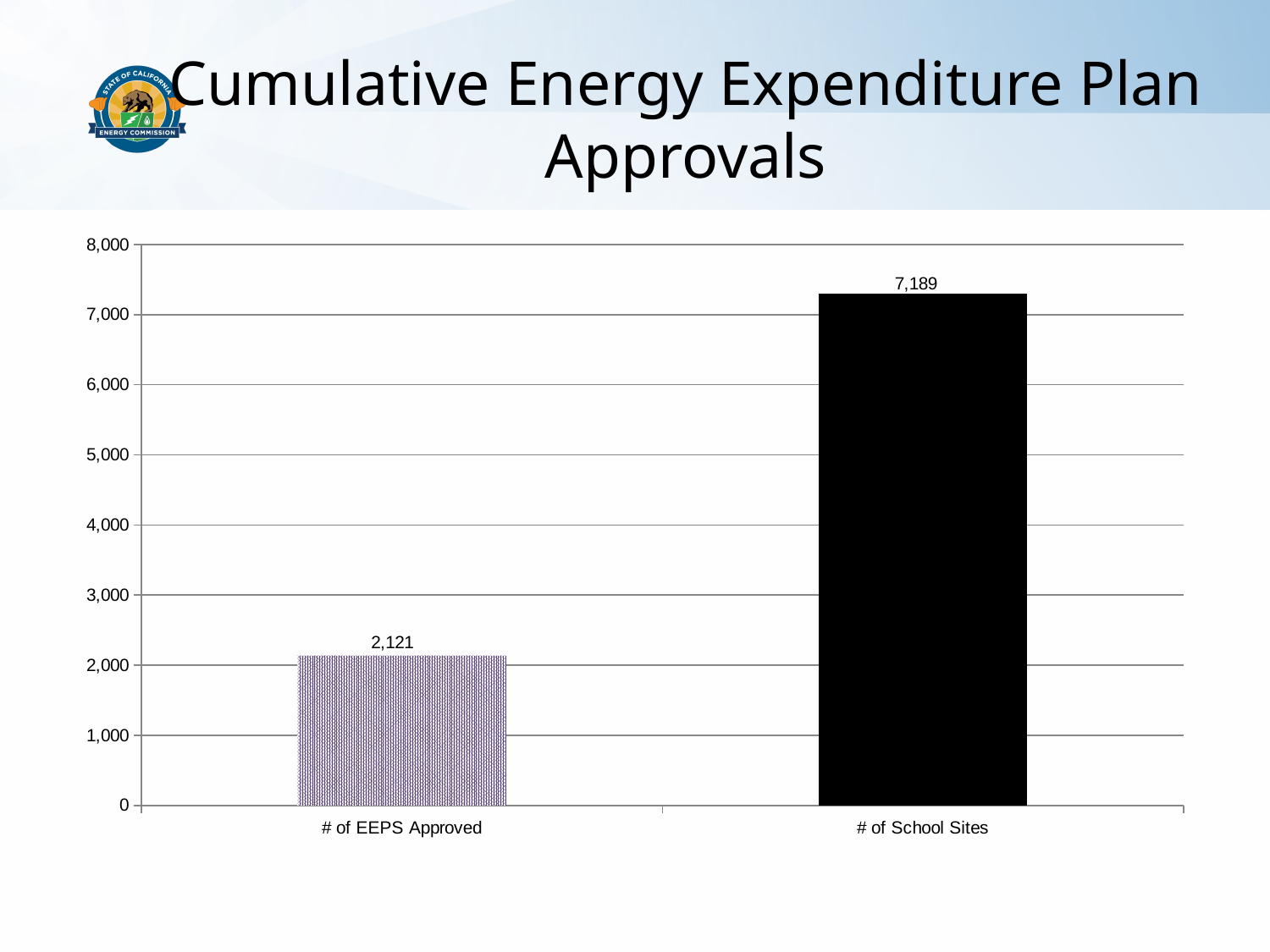
What is the difference between # of School Sites and # of EEPS Approved? 5,068 What is the title of the slide? Cumulative Energy Expenditure Plan Approvals How many categories are shown in the chart? 2 Is the value for # of School Sites greater or less than 7,000? greater What kind of chart is shown on the slide? bar chart Which is larger, # of EEPS Approved or # of School Sites? # of School Sites What is the value for # of EEPS Approved? 2,121 What is the value for # of School Sites? 7,189 Which category has the lowest value? # of EEPS Approved Is the value for # of EEPS Approved greater or less than 3,000? less Which category has the highest value? # of School Sites What is the highest value shown on the vertical axis? 8,000